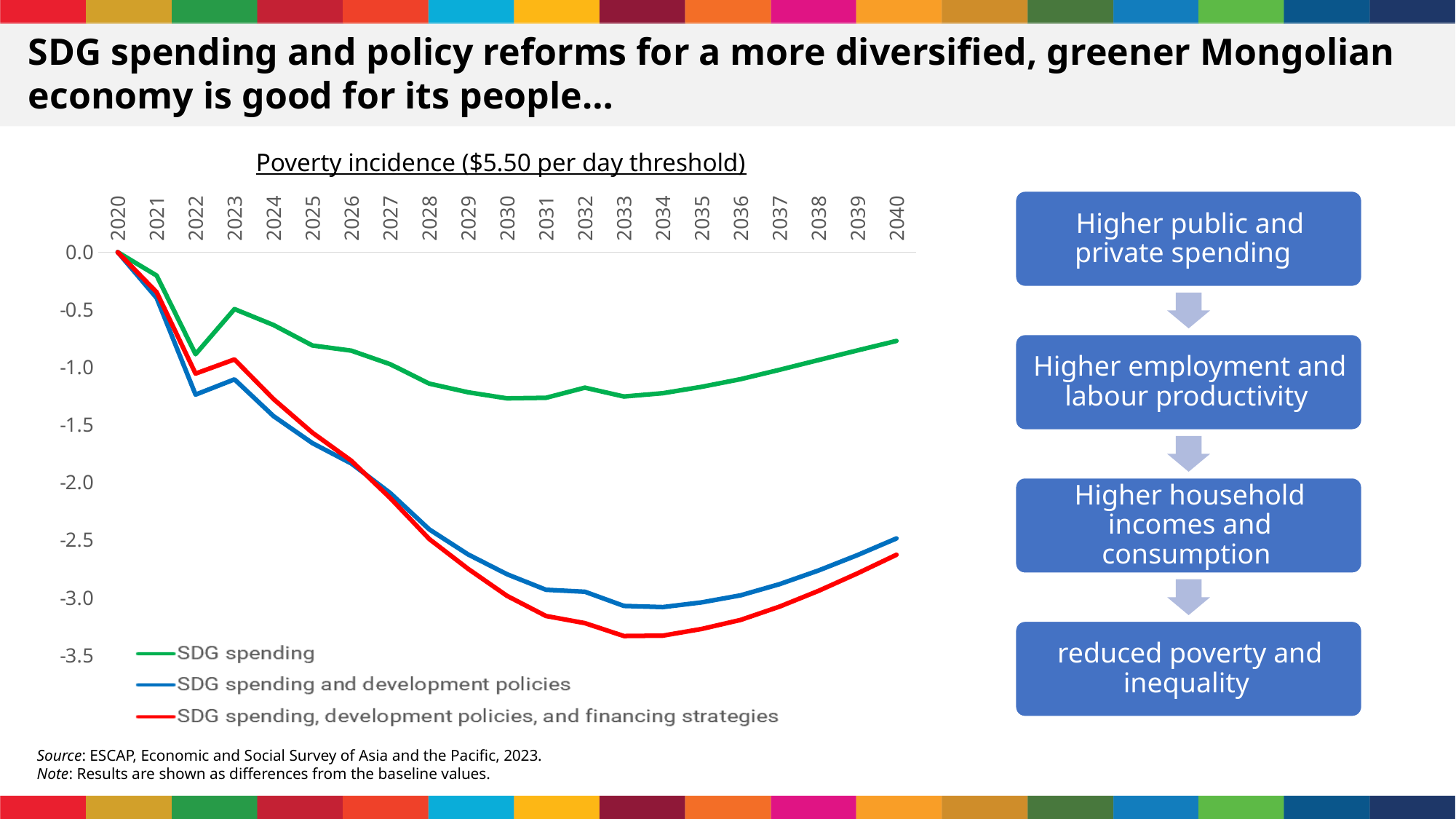
Does the SDG spending series rise or fall between 2033 and 2040? rise In 2040, which series has the higher value: SDG spending or SDG spending, development policies, and financing strategies? SDG spending Is the value for SDG spending in 2040 greater or less than -1.0? greater Is the value for SDG spending in 2030 greater or less than -1.0? less What is the title of the chart? Poverty incidence ($5.50 per day threshold) Is the value for SDG spending, development policies, and financing strategies in 2033 greater or less than -3.0? less What kind of chart is shown on the slide? line chart Which colour is used for the SDG spending series in the legend? green How many years are shown along the x axis of the chart? 21 What is the value of the SDG spending series in 2020? 0.0 How many series does the chart's legend list? 3